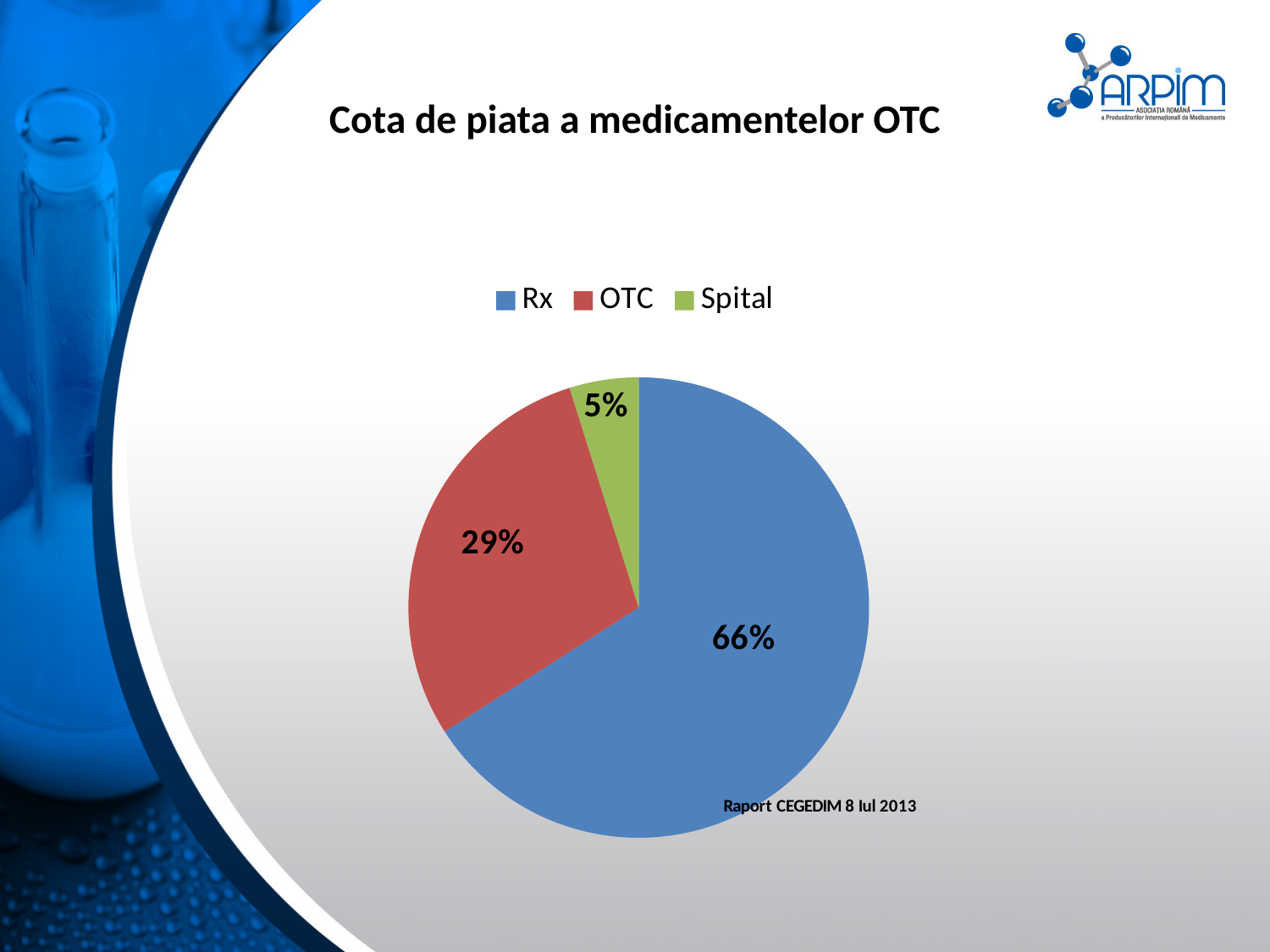
What is the difference in percentage points between the OTC and Spital slices? 24 What is the difference in percentage points between the Rx and OTC slices? 37 Which category has the smallest slice of the pie? Spital What is the title of the chart? Cota de piata a medicamentelor OTC What share of the pie does Rx have? 66% Which is larger, the OTC slice or the Spital slice? OTC What kind of chart is shown on the slide? pie chart What share of the pie does OTC have? 29% What share of the pie does Spital have? 5% What colour is the OTC slice in the pie chart? red Which category has the largest slice of the pie? Rx How many slices does the pie chart have? 3